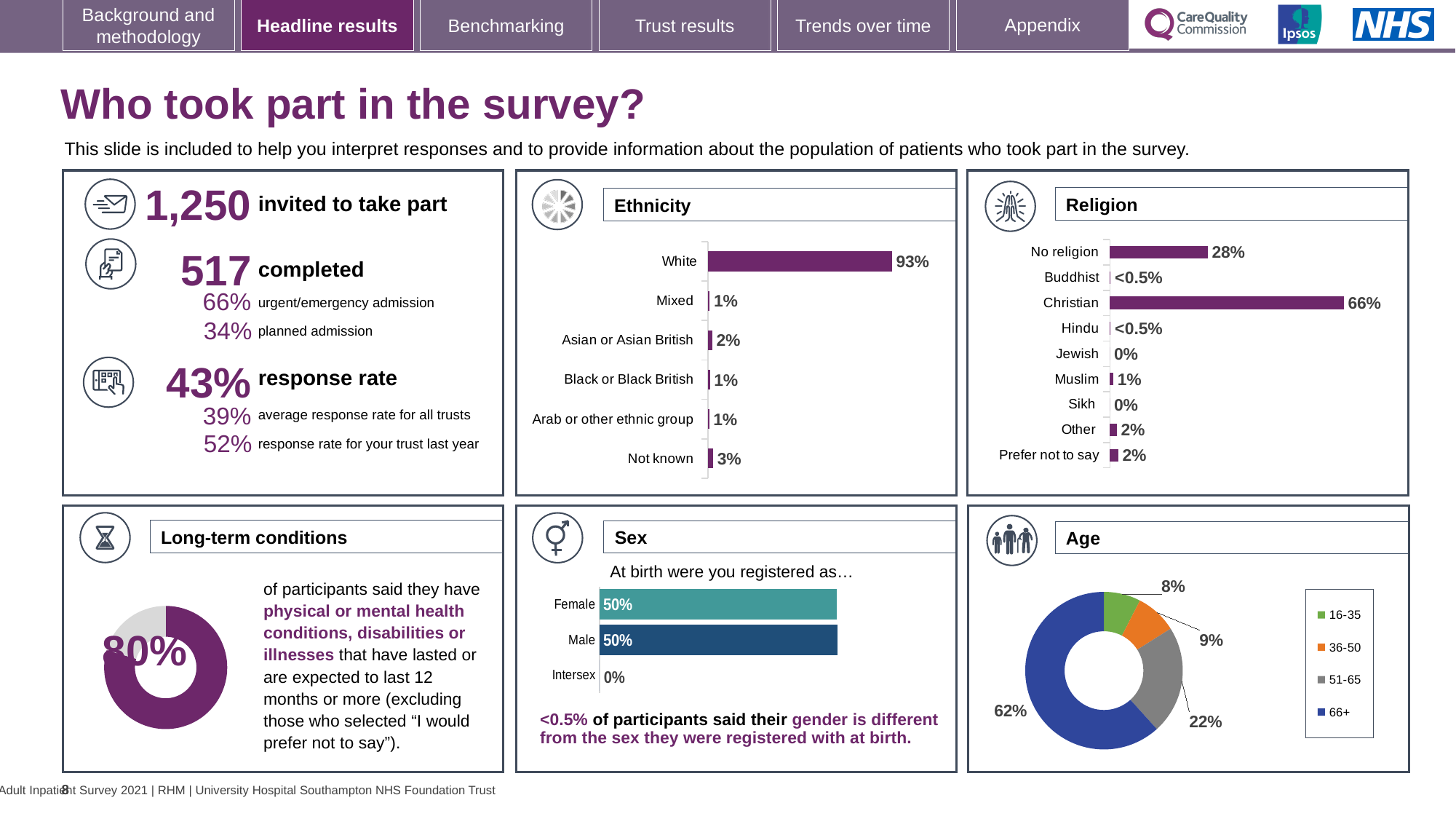
In the Age chart, which age group has the largest share? 66+ In the Religion chart, what is the difference between the Christian and No religion values? 38% In the Ethnicity chart, what percentage of participants were White? 93% In the Religion chart, which religion category has the highest value? Christian In the Religion chart, how many categories are listed? 9 In the Ethnicity chart, how many ethnic categories are shown? 6 In the Religion chart, what is the value for No religion? 28% In the Ethnicity chart, what is the value for Not known? 3% What type of chart is used for the Age breakdown? Donut (pie) chart In the Age chart, how many age groups does the legend list? 4 In the Sex chart, what percentage of participants were registered as Female at birth? 50% In the Age chart, what share of participants were aged 51-65? 22%